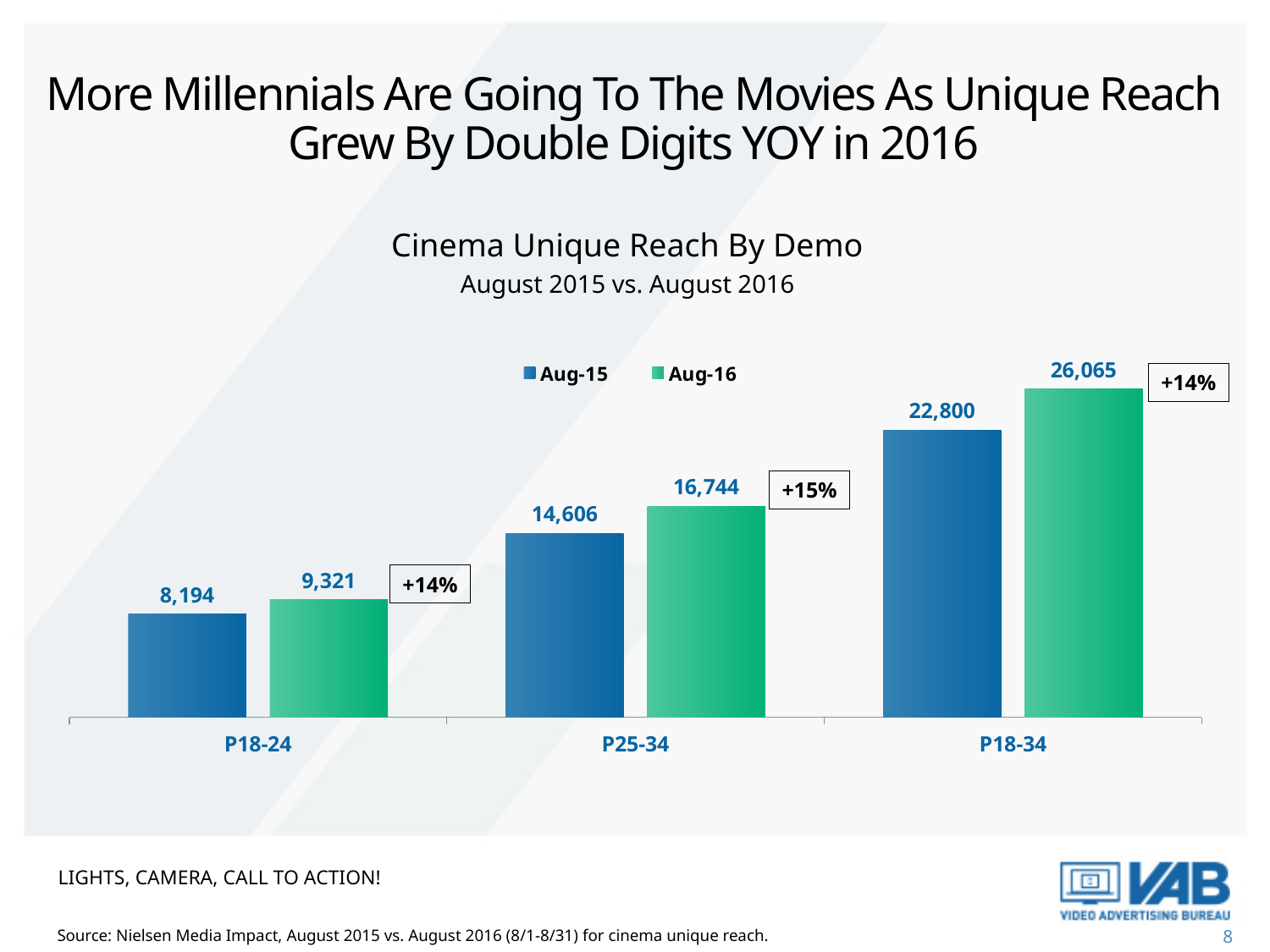
What is the Aug-15 cinema unique reach value for P18-24? 8,194 What percentage change is shown for P25-34? +15% What is the difference between the Aug-16 and Aug-15 values for P18-34? 3,265 How many demo categories are shown on the x axis? 3 What is the title of the chart? Cinema Unique Reach By Demo Which is larger for P25-34, the Aug-15 value or the Aug-16 value? Aug-16 What is the Aug-16 value for P18-34? 26,065 What kind of chart is shown on the slide? Bar chart Which demo has the lowest Aug-15 value? P18-24 Which demo has the highest Aug-16 value? P18-34 What is the Aug-16 cinema unique reach value for P25-34? 16,744 How many series does the legend list? 2